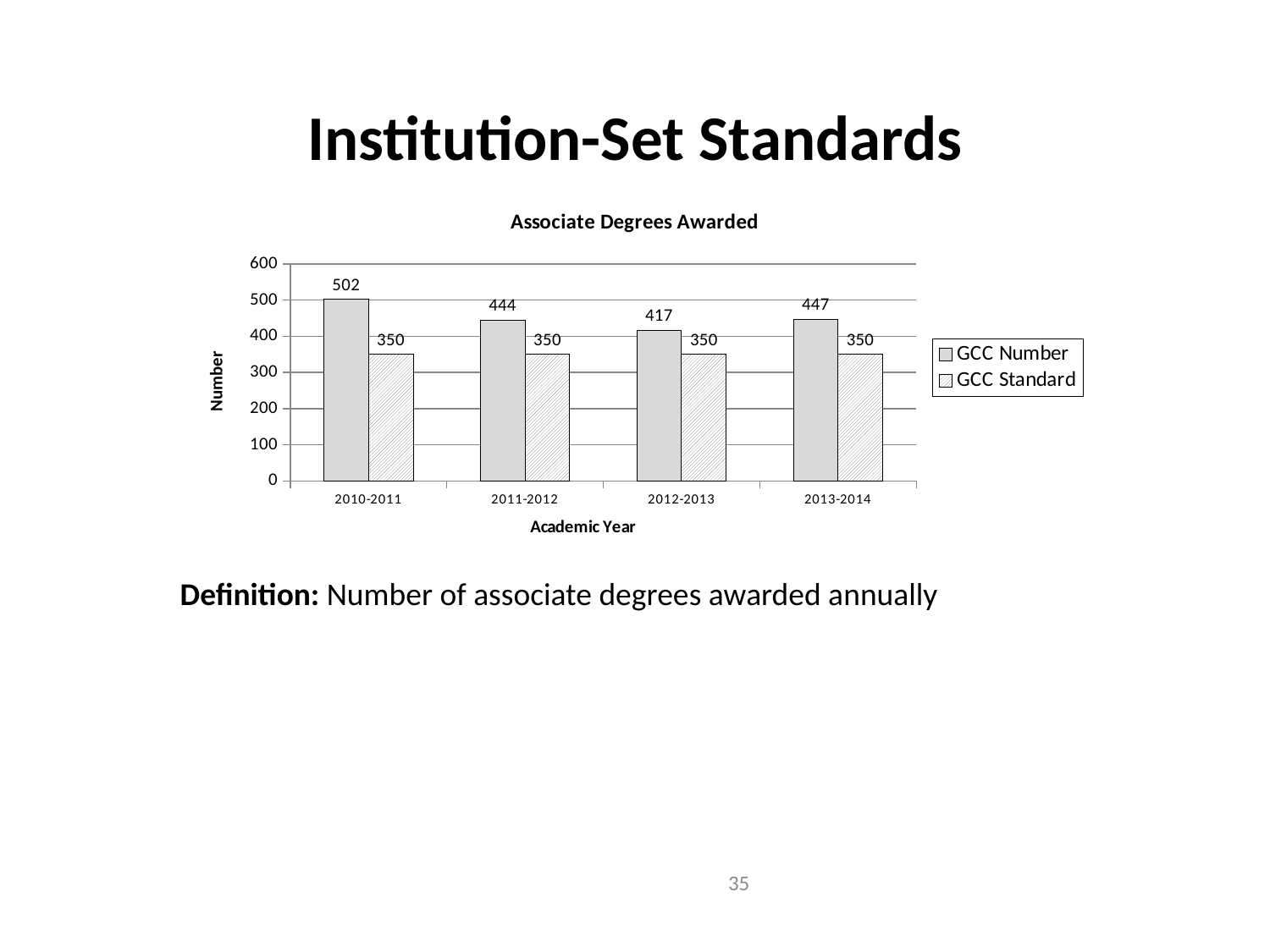
What is the GCC Standard value for 2013-2014? 350 How many series does the legend list? 2 By how much does the GCC Number in 2010-2011 exceed the GCC Number in 2013-2014? 55 Which academic year has the lowest GCC Number? 2012-2013 What is the title of the chart? Associate Degrees Awarded What kind of chart is shown on the slide? bar chart How many academic years are shown on the x axis? 4 What is the difference between the GCC Number and the GCC Standard in 2011-2012? 94 Is the GCC Number for 2013-2014 larger or smaller than the GCC Number for 2011-2012? larger Which academic year has the highest GCC Number? 2010-2011 What is the GCC Number of associate degrees awarded in 2010-2011? 502 What is the GCC Number value for 2012-2013? 417